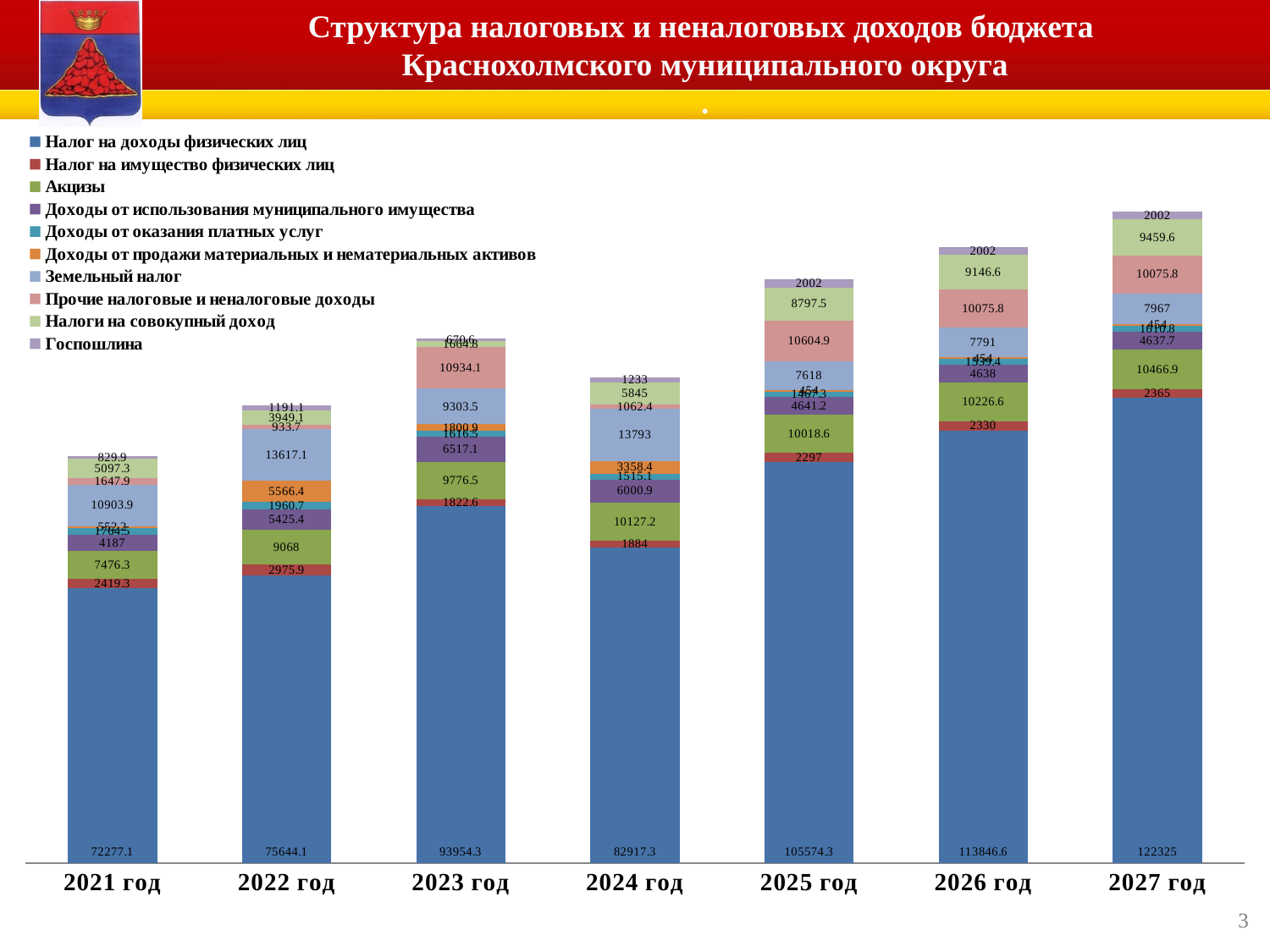
How many years (categories) are shown along the x axis? 7 Which series is listed first in the legend? Налог на доходы физических лиц Which year has the lowest value for Налог на доходы физических лиц? 2021 год How many series does the legend list? 10 What is the value of Акцизы for 2022 год? 9068 What is the value of Земельный налог for 2024 год? 13793 What is the value of Налог на доходы физических лиц for 2027 год? 122325 What is the difference between the Налог на доходы физических лиц values for 2027 год and 2026 год? 8478.4 Which year has the highest value for Налог на доходы физических лиц? 2027 год Which is larger: Земельный налог in 2022 год or in 2023 год? 2022 год What type of chart is shown on the slide? Stacked bar chart What is the value of Налог на доходы физических лиц for 2021 год? 72277.1